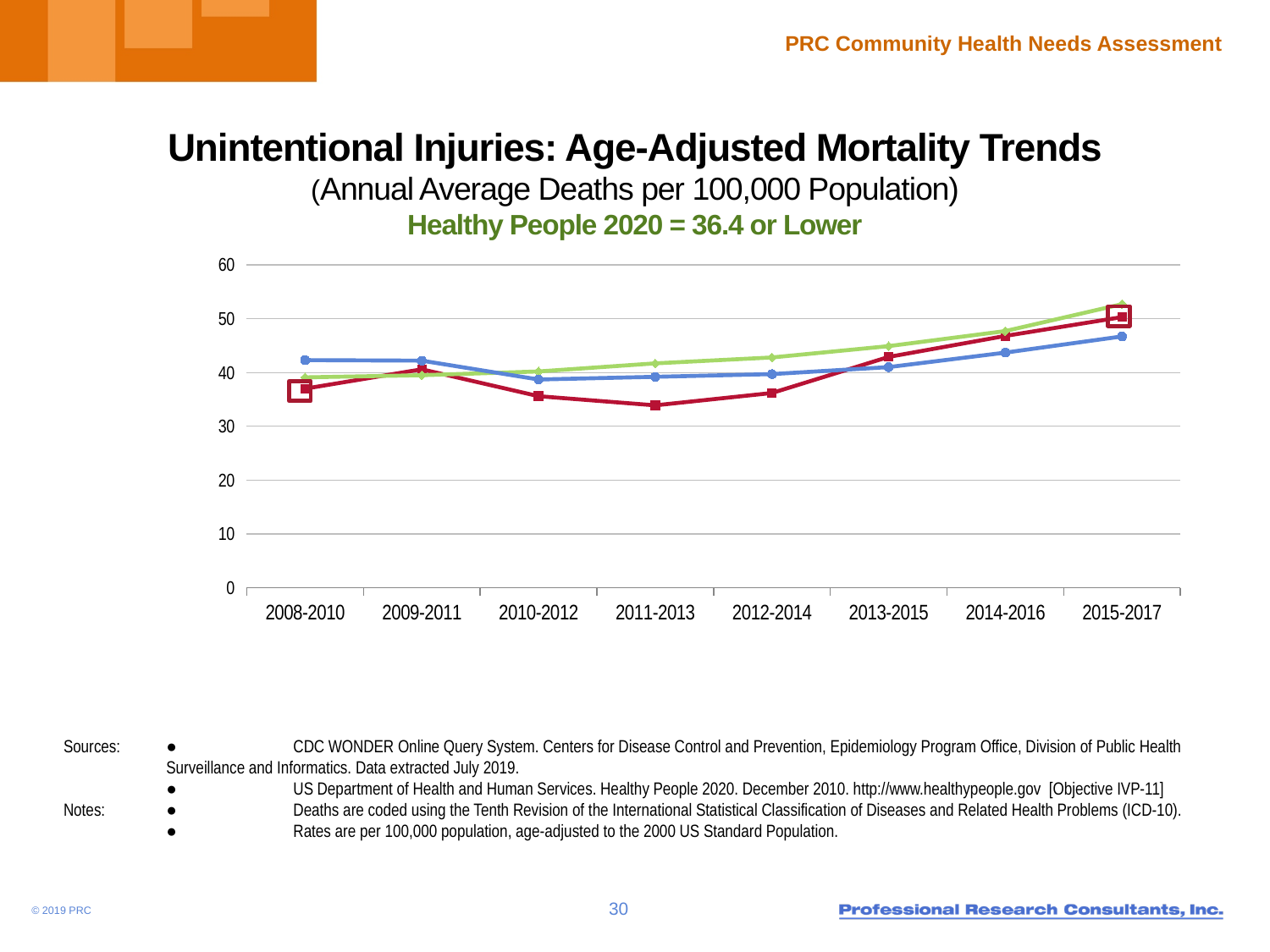
Is the value of the red line for 2011-2013 greater or less than 40? less In which period does the red line reach its highest value? 2015-2017 Is the value of the green line for 2015-2017 greater or less than 50? greater What is the Healthy People 2020 target stated above the chart? 36.4 or Lower In which period does the red line reach its lowest value? 2011-2013 Does the green line generally rise or fall from 2008-2010 to 2015-2017? rise How many lines are plotted on the chart? 3 How many time periods are shown along the x axis of the chart? 8 For 2008-2010, which line has the higher value, the blue line or the red line? blue line What kind of chart is shown on the slide? line chart What is the title of the chart on the slide? Unintentional Injuries: Age-Adjusted Mortality Trends Is the value of the blue line for 2008-2010 greater or less than 40? greater